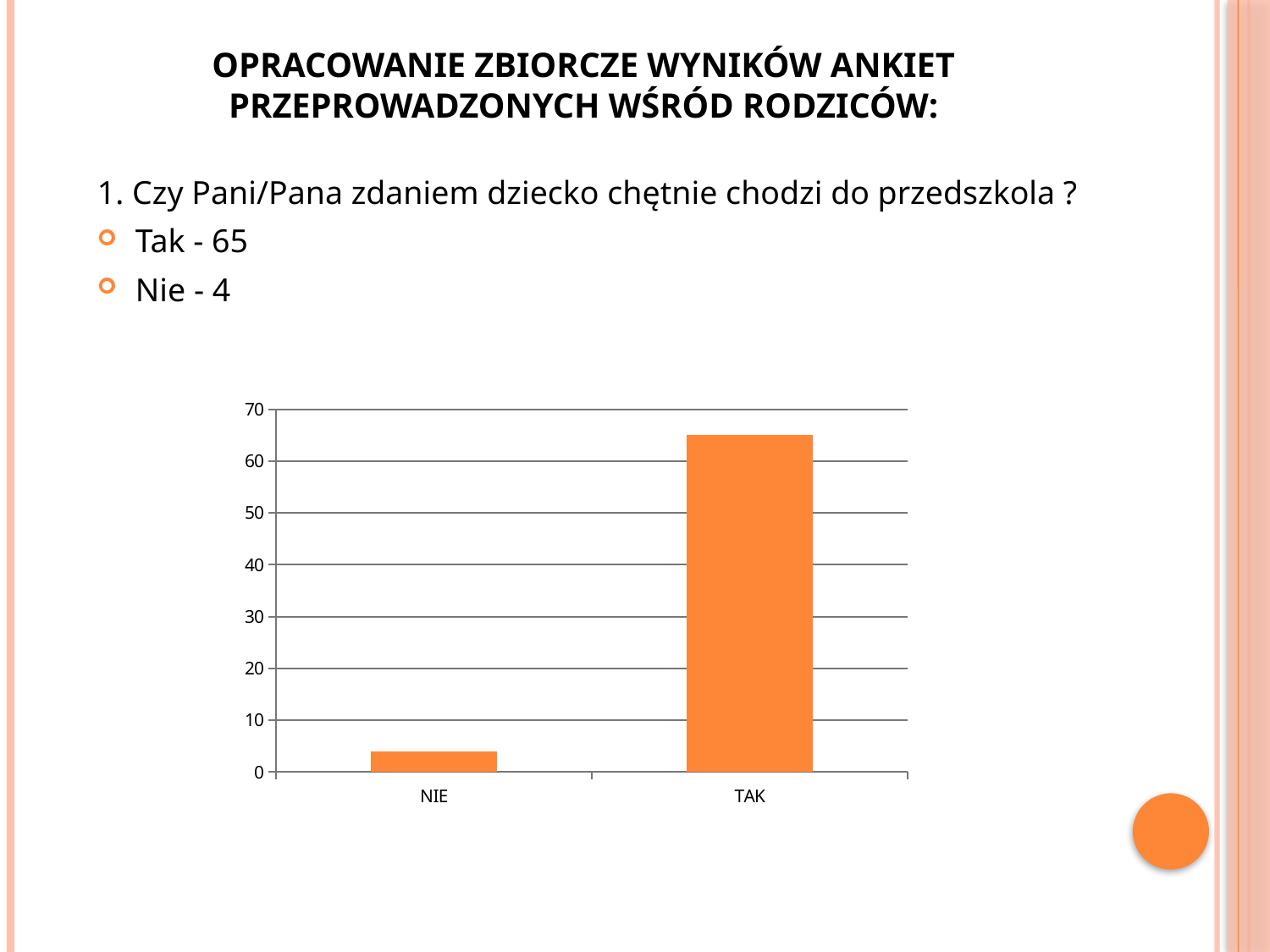
Which is larger, the value for NIE or the value for TAK? TAK Which category has the highest bar in the chart? TAK Is the value for NIE greater or less than 10? less Which category has the lowest bar in the chart? NIE What is the value for NIE in the chart? 4 What is the difference between the values for TAK and NIE? 61 What is the highest value shown on the y axis of the chart? 70 What type of chart is shown on the slide? bar chart What is the value for TAK in the chart? 65 Is the value for TAK greater or less than 60? greater What colour are the bars in the chart? orange How many categories are shown on the x axis of the chart? 2